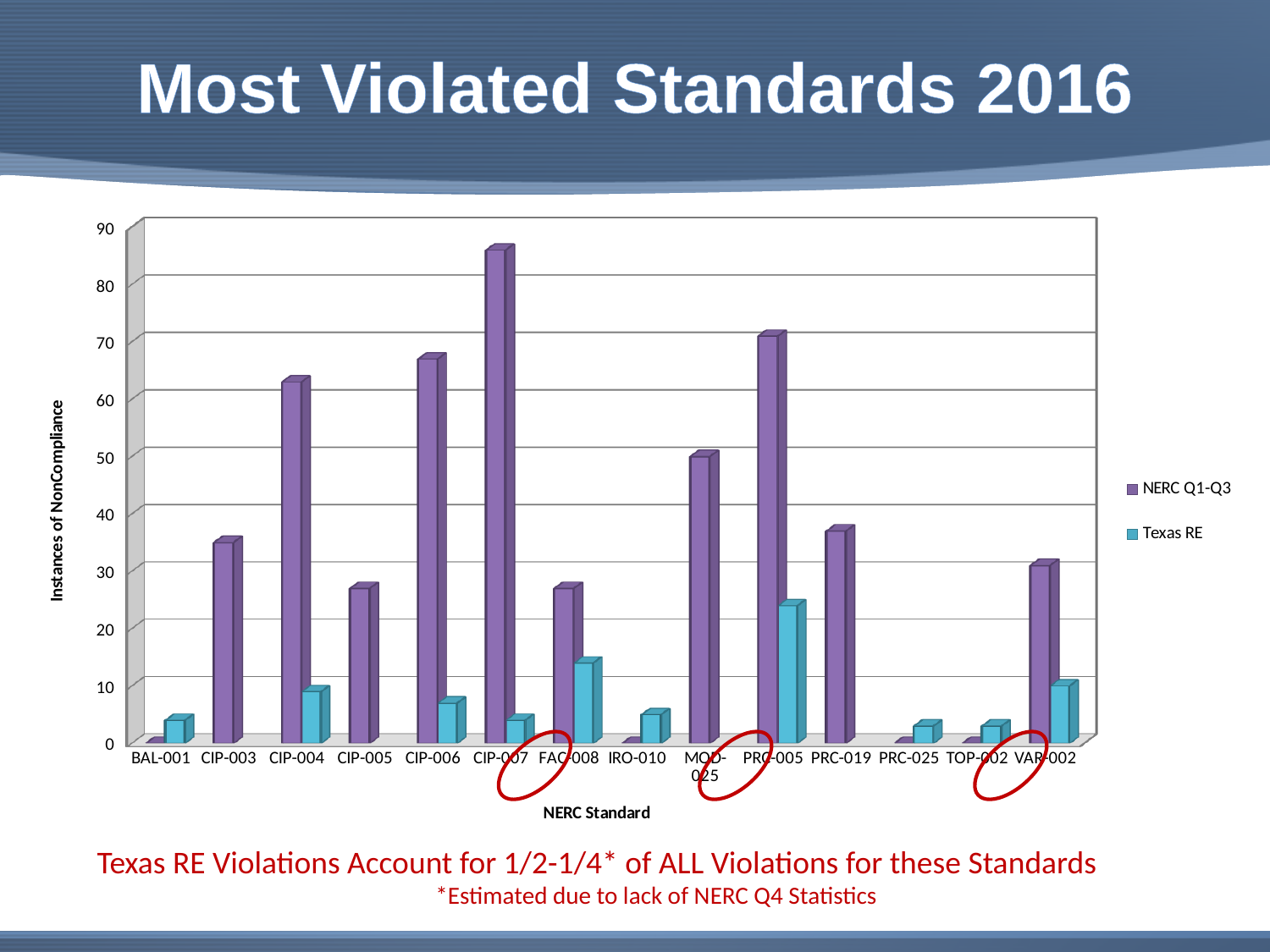
How many NERC standards (categories) are shown on the x axis? 14 Is the NERC Q1-Q3 value for CIP-003 greater or less than 40? less Is the NERC Q1-Q3 value for CIP-007 greater or less than 80? greater How many series does the legend list? 2 Is the Texas RE value for FAC-008 greater or less than 10? greater What is the label of the y axis? Instances of NonCompliance Which is larger, the Texas RE value for PRC-005 or for VAR-002? PRC-005 Which NERC standard has the highest NERC Q1-Q3 value? CIP-007 Which NERC standard has the highest Texas RE value? PRC-005 What kind of chart is shown on the slide? bar chart Which is larger, the NERC Q1-Q3 value for CIP-007 or for PRC-005? CIP-007